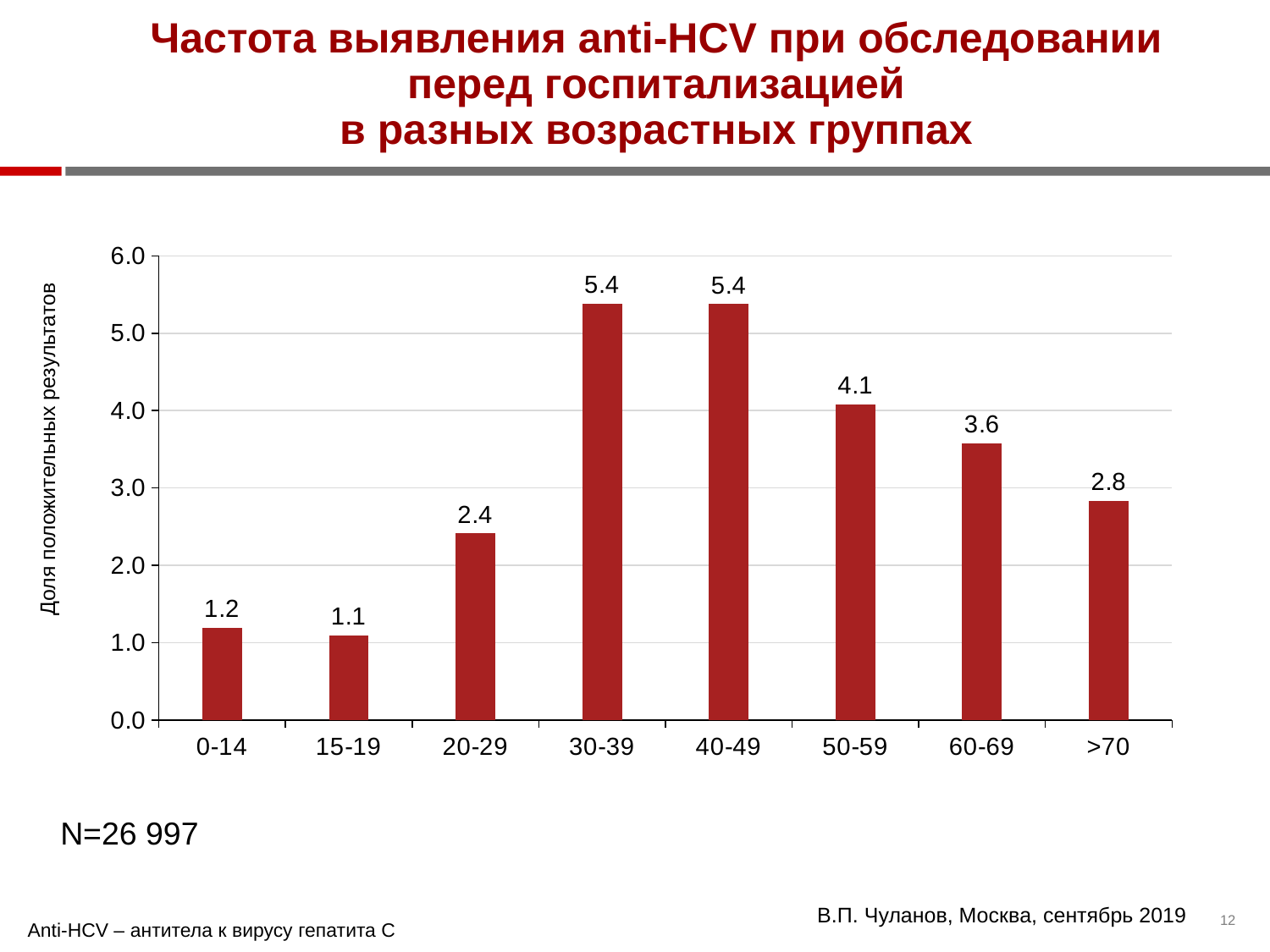
What is the label of the vertical axis? Доля положительных результатов Which is larger, the value for 50-59 or the value for 60-69? 50-59 What is the value for the 30-39 age group? 5.4 What is the value for the 0-14 age group? 1.2 What is the difference between the values for the 40-49 and >70 age groups? 2.6 What is the value for the 60-69 age group? 3.6 What is the value for the >70 age group? 2.8 Is the value for the 20-29 age group greater or less than 2.0? greater What kind of chart is shown on the slide? bar chart Which age group has the lowest value? 15-19 How many age groups are shown on the x axis? 8 What is the difference between the values for the 50-59 and 20-29 age groups? 1.7